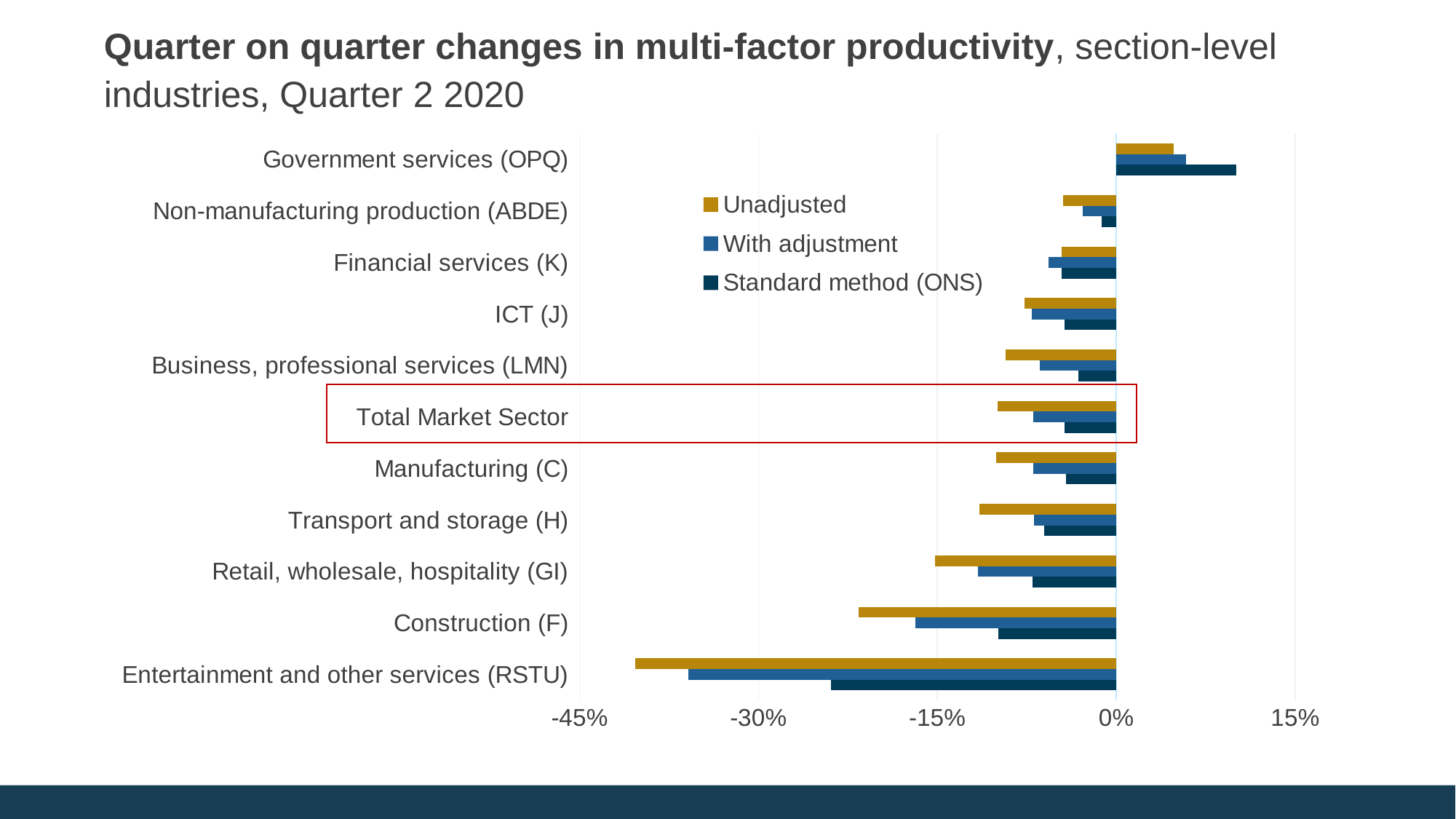
What kind of chart is shown on the slide? Bar chart Which has the larger Unadjusted value: Construction (F) or Entertainment and other services (RSTU)? Construction (F) How many series does the legend list? 3 Which category is highlighted with a red box on the chart? Total Market Sector Is the Standard method (ONS) value for Entertainment and other services (RSTU) greater or less than -15%? less Is the Unadjusted value for Construction (F) greater or less than -15%? less Is the Standard method (ONS) value for Government services (OPQ) greater or less than 0%? greater Which category has the highest value for the Standard method (ONS) series? Government services (OPQ) Which category has the lowest value for the Unadjusted series? Entertainment and other services (RSTU) For Government services (OPQ), which series has the larger value: Unadjusted or Standard method (ONS)? Standard method (ONS) How many industry categories are plotted on the chart? 11